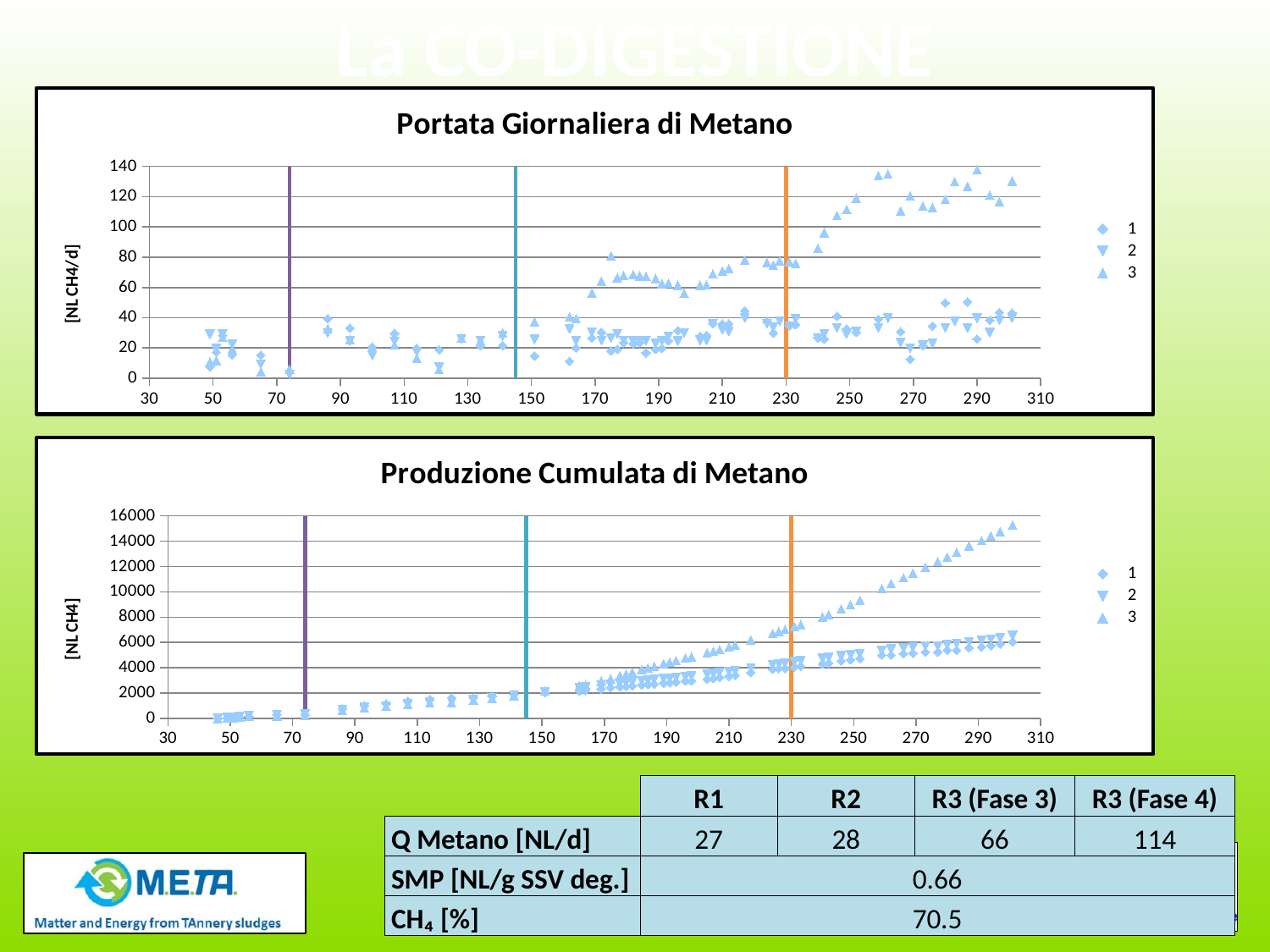
In "Produzione Cumulata di Metano", is the value of series 3 at x = 300 greater or less than 14000? greater In "Produzione Cumulata di Metano", is the value of series 3 at x = 250 greater or less than 8000? greater In "Portata Giornaliera di Metano", is the value of series 3 at x = 260 greater or less than 120? greater What is the title of the lower chart on the slide? Produzione Cumulata di Metano In "Portata Giornaliera di Metano", at x = 290, which series has the larger value, series 2 or series 3? series 3 What is the y-axis label of the "Portata Giornaliera di Metano" chart? [NL CH4/d] What kind of chart is "Portata Giornaliera di Metano"? scatter chart In "Produzione Cumulata di Metano", do the values of series 3 rise or fall as x increases? rise In "Produzione Cumulata di Metano", at x = 300, which series has the larger value, series 1 or series 3? series 3 How many series does the legend of "Produzione Cumulata di Metano" list? 3